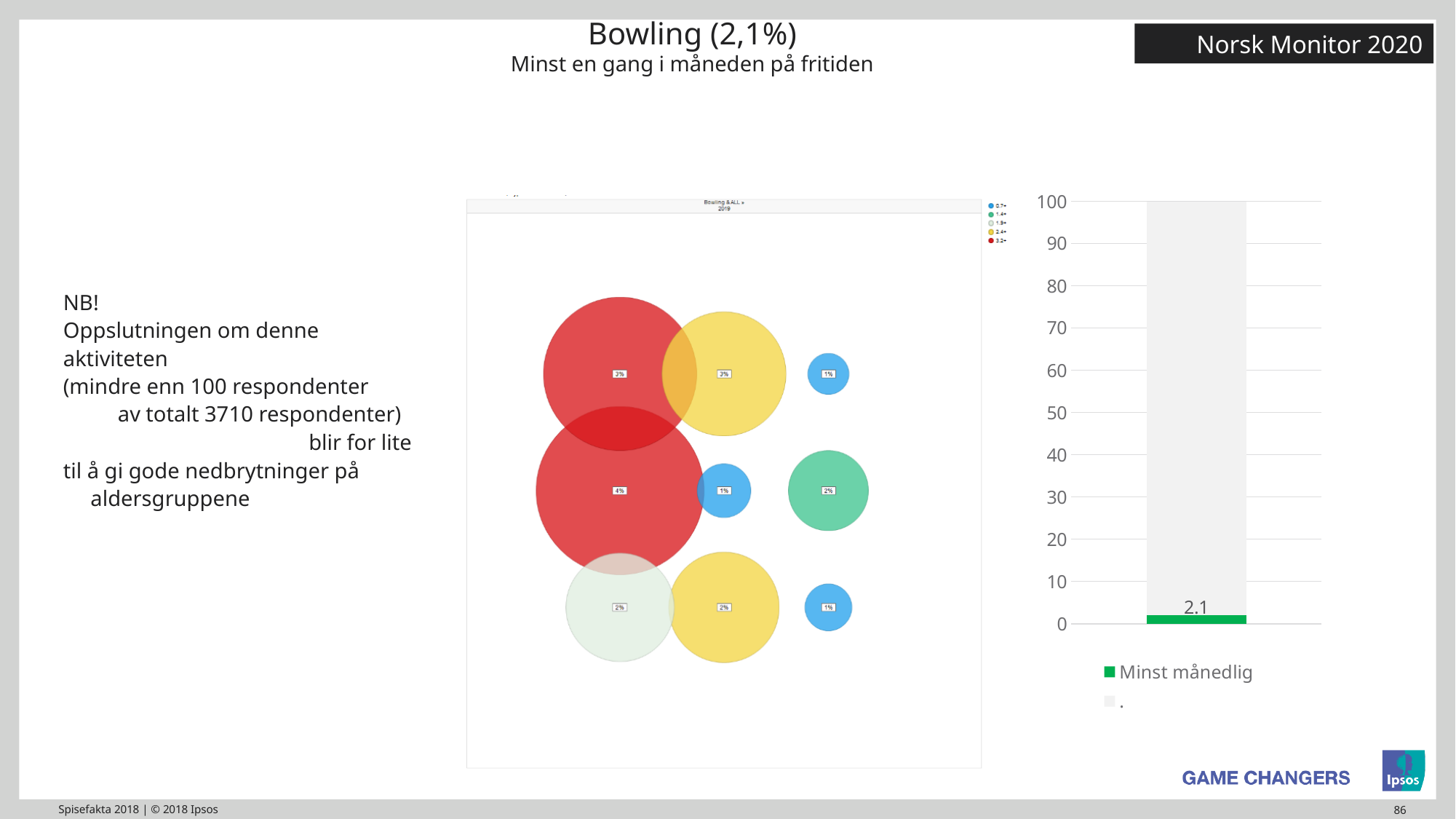
What is the first legend entry of the bar chart on the right? Minst månedlig How many series does the legend of the bar chart on the right list? 2 How many bubbles are plotted in the bubble chart in the middle of the slide? 9 How many bars are plotted in the bar chart on the right? 1 What kind of chart is shown in the middle of the slide? bubble chart In the bubble chart in the middle of the slide, what value is printed in the largest bubble? 4% What colour is the Minst månedlig series in the bar chart on the right? green In the bar chart on the right, is the value for Minst månedlig greater or less than 10? less In the bar chart on the right, what is the value for Minst månedlig? 2.1 In the bubble chart in the middle of the slide, how many bubbles are labelled 1%? 3 What kind of chart is shown on the right side of the slide? bar chart